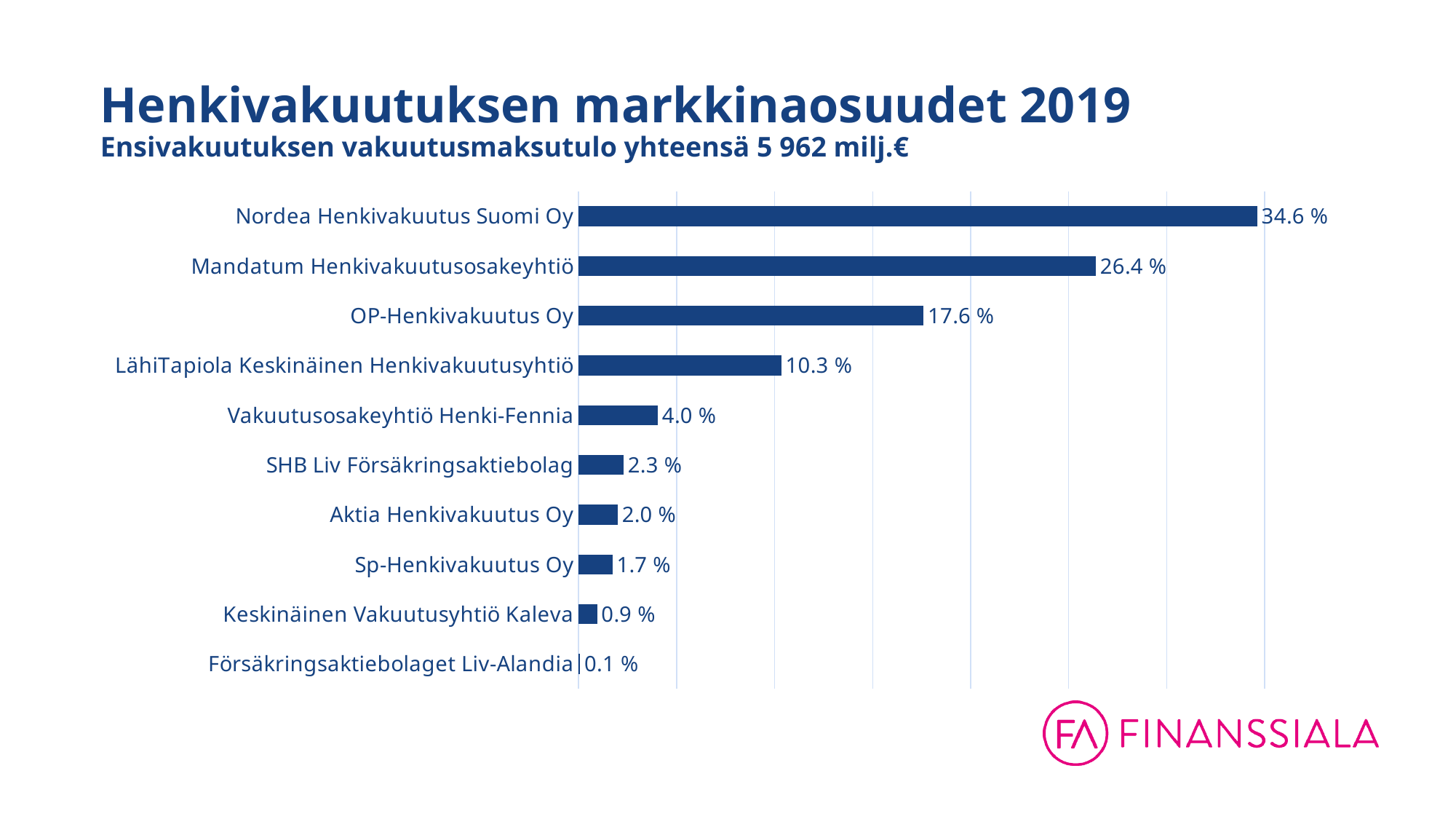
How many companies are shown in the chart? 10 What is the title of the chart on the slide? Henkivakuutuksen markkinaosuudet 2019 Which has a larger market share, SHB Liv Försäkringsaktiebolag or Aktia Henkivakuutus Oy? SHB Liv Försäkringsaktiebolag What is the market share shown for Nordea Henkivakuutus Suomi Oy? 34.6 % According to the subtitle, what is the total premium income (vakuutusmaksutulo) of direct insurance? 5 962 milj.€ What is the difference in market share between OP-Henkivakuutus Oy and LähiTapiola Keskinäinen Henkivakuutusyhtiö? 7.3 % What is the market share shown for Keskinäinen Vakuutusyhtiö Kaleva? 0.9 % What is the difference in market share between Nordea Henkivakuutus Suomi Oy and Mandatum Henkivakuutusosakeyhtiö? 8.2 % Which company has the lowest market share in the chart? Försäkringsaktiebolaget Liv-Alandia What is the market share shown for OP-Henkivakuutus Oy? 17.6 % Which company has the highest market share in the chart? Nordea Henkivakuutus Suomi Oy What kind of chart is shown on the slide? Bar chart